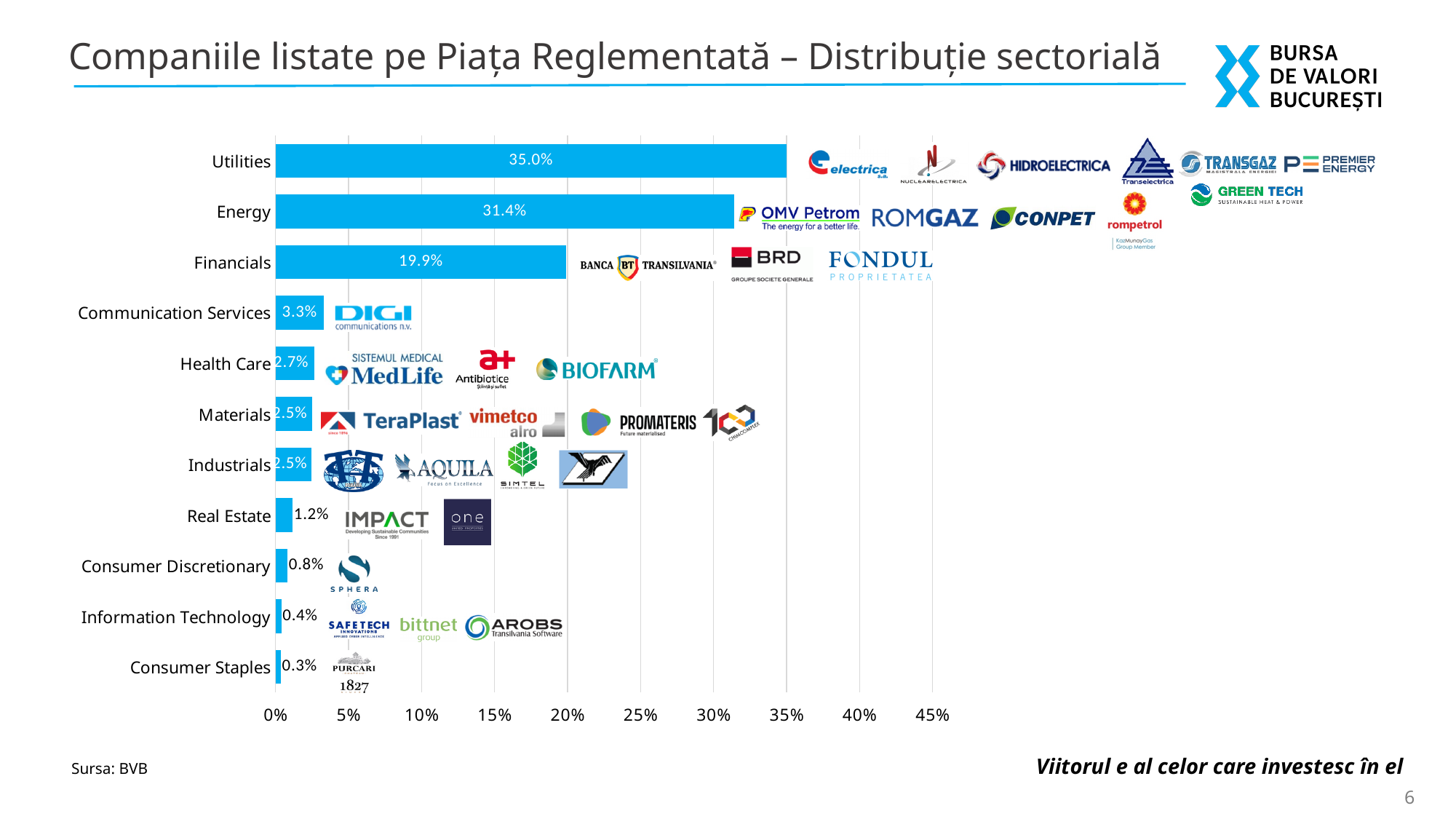
What is the value for Utilities? 35.0% What is the difference between the Utilities and Energy values? 3.6% What kind of chart is shown on the slide? bar chart What is the value for Real Estate? 1.2% What is the value for Information Technology? 0.4% Which sector has the highest share? Utilities Which sector has the lowest share? Consumer Staples What is the value for Financials? 19.9% What is the title of the slide? Companiile listate pe Piața Reglementată – Distribuție sectorială Which is larger, Communication Services or Health Care? Communication Services How many sectors are shown in the chart? 11 Is the value for Energy greater or less than 30%? greater